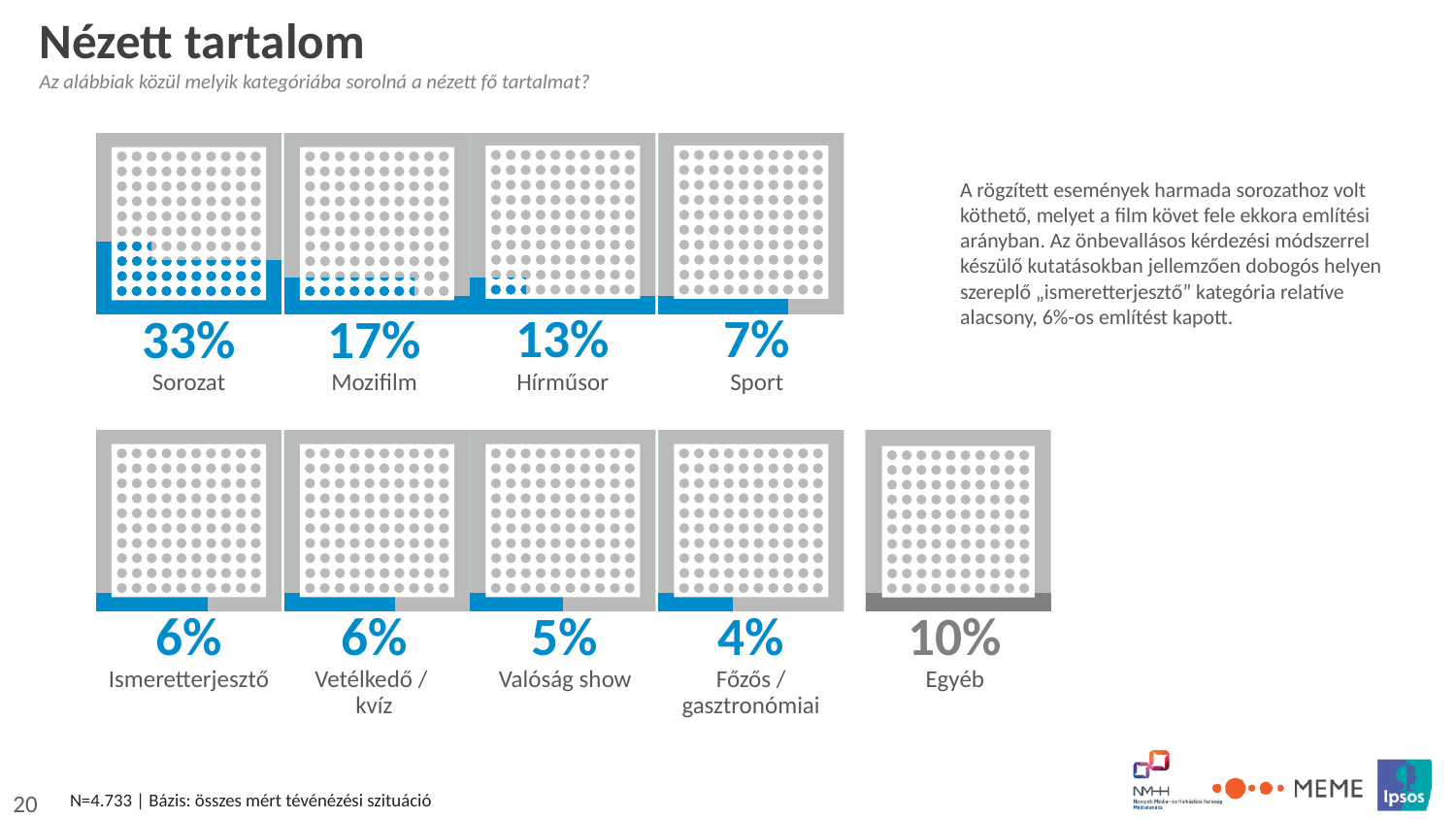
What is the difference in percentage points between Hírműsor and Valóság show? 8 What percentage is shown for Egyéb? 10% Which category has the lowest percentage? Főzős / gasztronómiai What is the difference in percentage points between Sorozat and Mozifilm? 16 What is the title of the slide? Nézett tartalom What percentage is shown for Főzős / gasztronómiai? 4% How many categories are shown on the slide? 9 What percentage is shown for Mozifilm? 17% What percentage is shown for Sorozat? 33% What percentage is shown for Hírműsor? 13% Which has a higher percentage, Sport or Egyéb? Egyéb Which category has the highest percentage? Sorozat